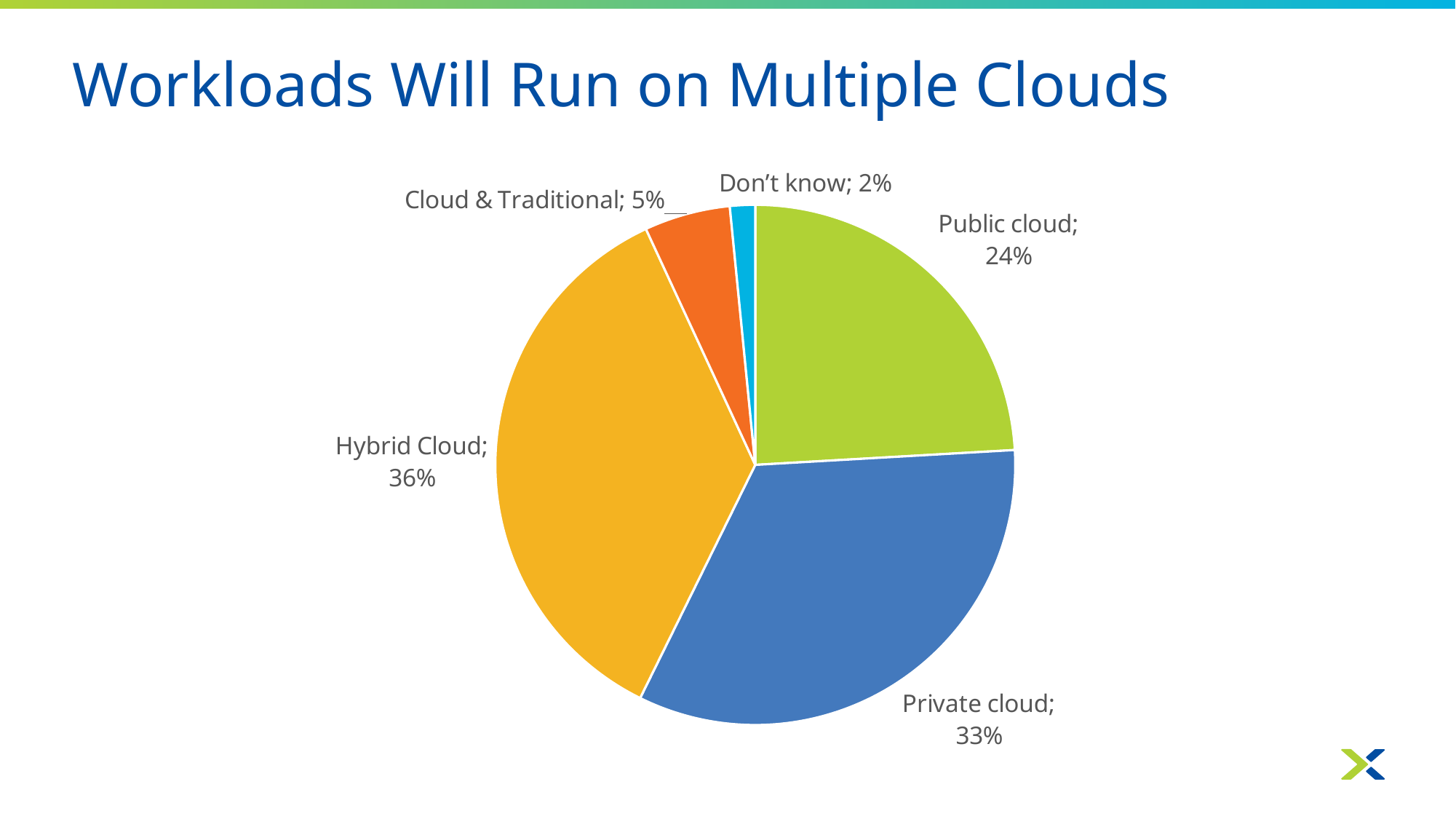
What kind of chart is shown on the slide? pie chart What is the value for Don't know? 2% Which is larger, Public cloud or Private cloud? Private cloud What share of the pie is Hybrid Cloud? 36% What is the difference between Hybrid Cloud and Private cloud? 3% What is the title of the slide? Workloads Will Run on Multiple Clouds Which category has the largest slice? Hybrid Cloud Which category has the smallest slice? Don't know What is the value for Cloud & Traditional? 5% What is the value for Private cloud? 33% What is the value for Public cloud? 24% How many slices does the pie chart have? 5